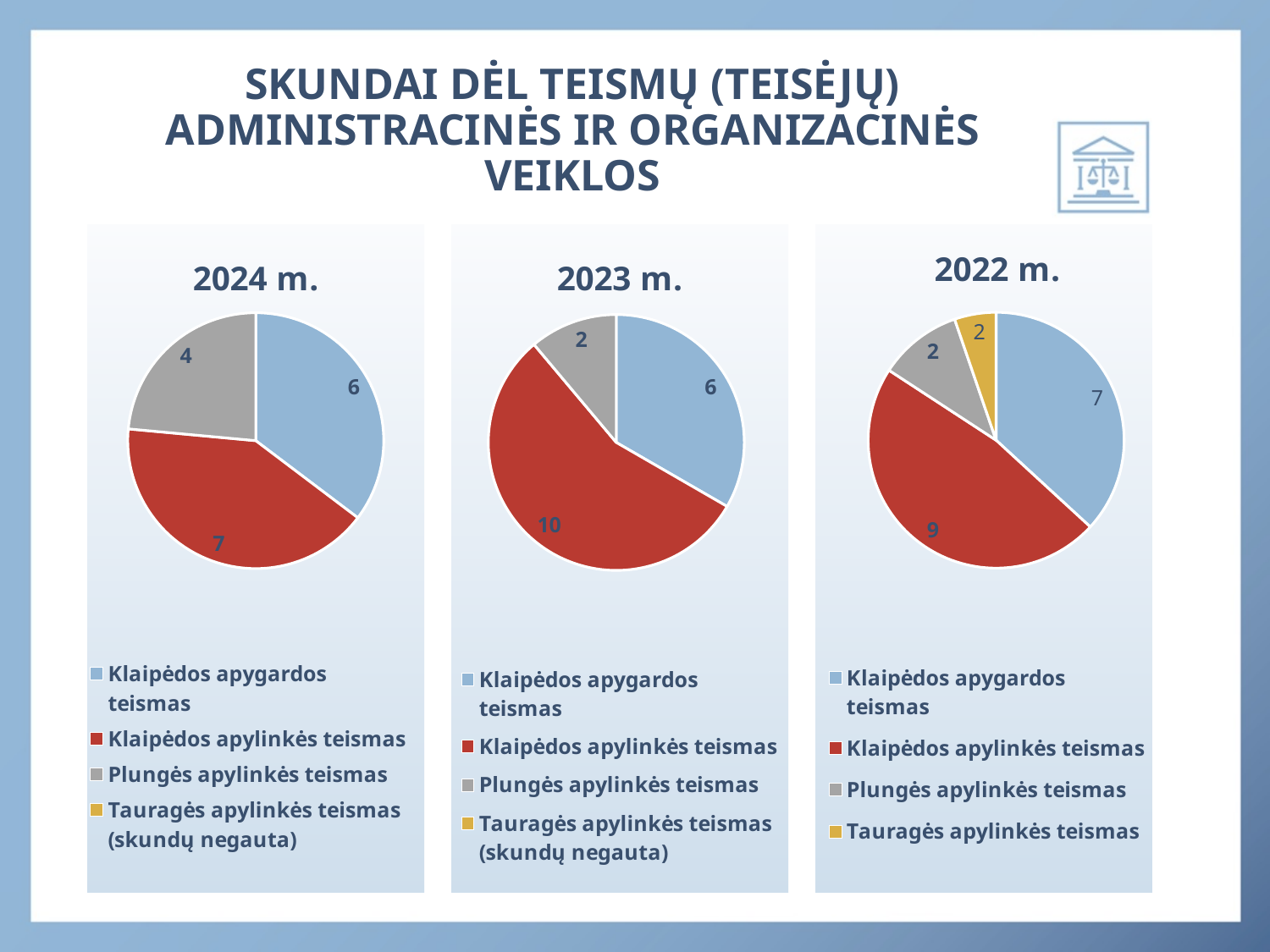
In the 2024 m. chart, what is the value for Plungės apylinkės teismas? 4 How many legend entries does the 2022 m. chart list? 4 What type of chart is used for the 2024 m. data? Pie chart In the 2023 m. chart, what is the value for Klaipėdos apylinkės teismas? 10 In the 2022 m. chart, what is the value for Klaipėdos apygardos teismas? 7 In the 2024 m. chart, which category has the smallest non-zero slice? Plungės apylinkės teismas What is the total of all slices in the 2023 m. chart? 18 In the 2022 m. chart, what share of the total does Klaipėdos apylinkės teismas represent? 47% In the 2023 m. chart, what is the difference between Klaipėdos apylinkės teismas and Klaipėdos apygardos teismas? 4 In the 2024 m. chart, what is the value for Klaipėdos apylinkės teismas? 7 In the 2023 m. chart, which category has the largest slice? Klaipėdos apylinkės teismas In the 2022 m. chart, which is larger: Klaipėdos apylinkės teismas or Klaipėdos apygardos teismas? Klaipėdos apylinkės teismas